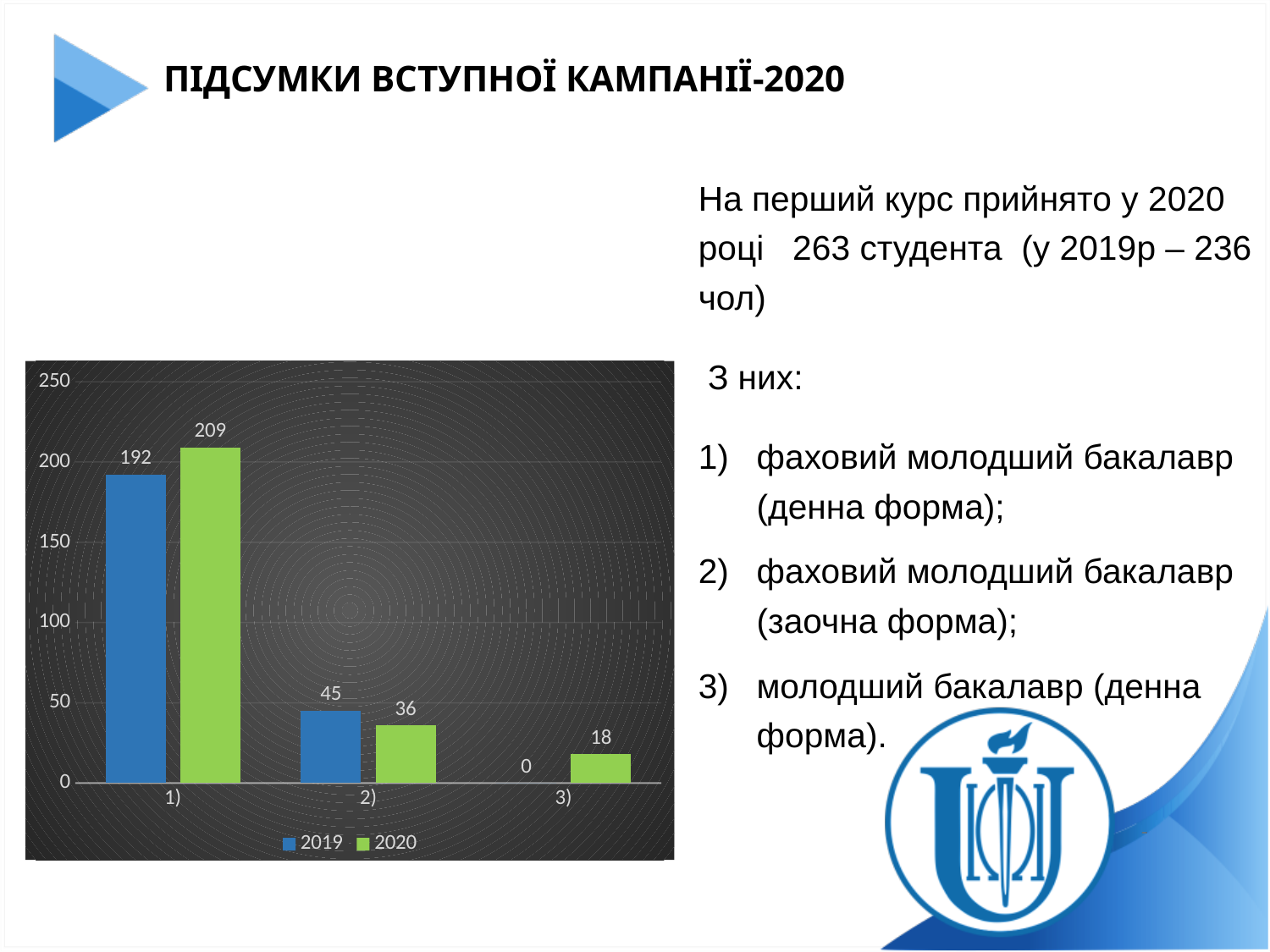
What is the value for category 2) in the 2020 series? 36 How many series does the legend list? 2 How many categories are shown on the x axis? 3 For category 2), which series has the larger value, 2019 or 2020? 2019 What is the value for category 1) in the 2020 series? 209 Which category has the highest value in the 2020 series? 1) What is the difference between the 2020 and 2019 values for category 1)? 17 What kind of chart is shown on the slide? bar chart Which category has the lowest value in the 2019 series? 3) What colour are the bars for the 2020 series? green What is the value for category 1) in the 2019 series? 192 What is the value for category 3) in the 2019 series? 0